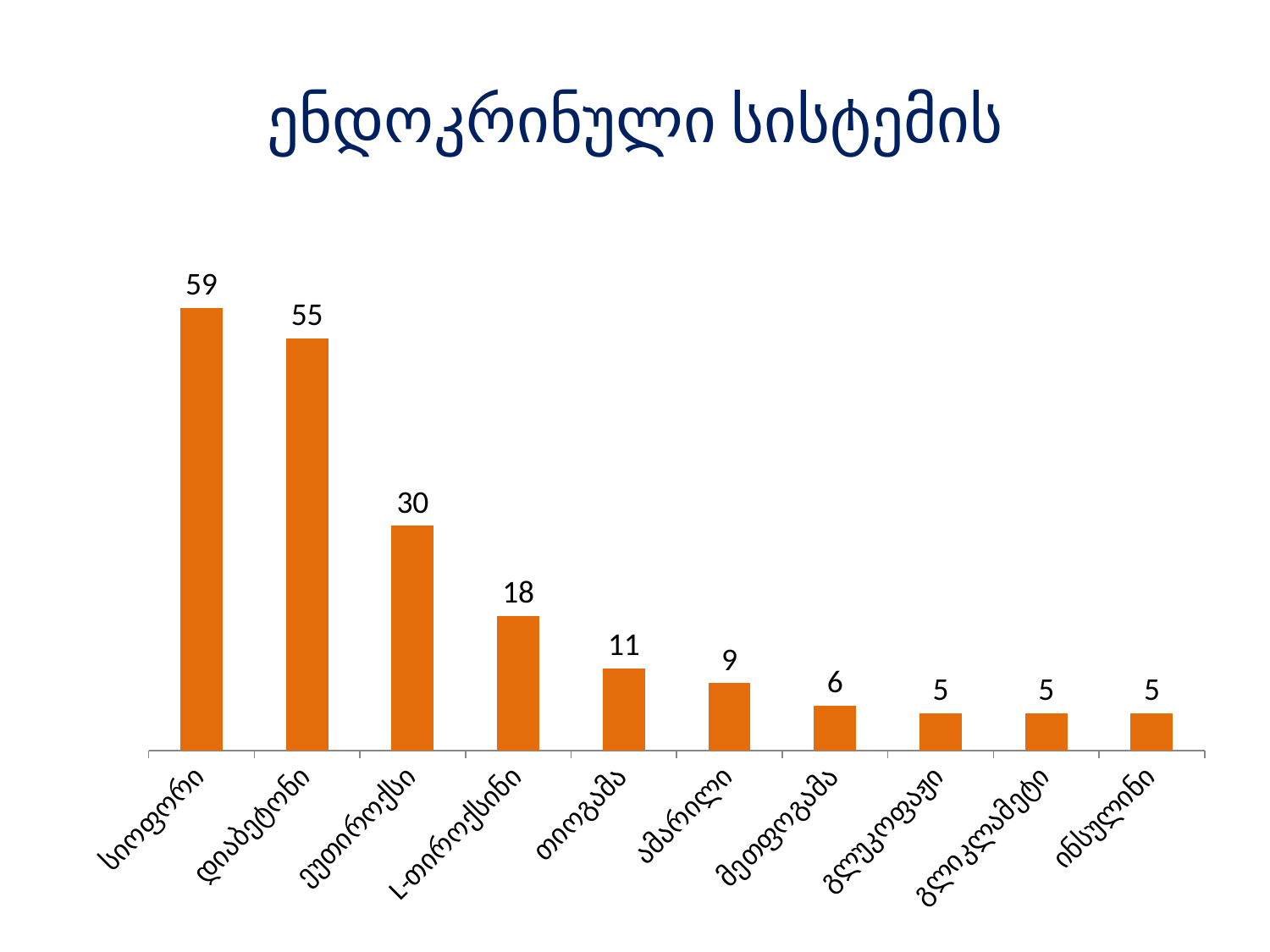
What is the difference between the values for ეუთიროქსი and L-თიროქსინი? 12 Which is larger, the value for ამარილი or the value for მეთფოგამა? ამარილი What is the title of the chart? ენდოკრინული სისტემის What is the difference between the values for სიოფორი and დიაბეტონი? 4 What colour are the bars in the chart? orange How many categories are shown on the x axis? 10 What kind of chart is shown on the slide? bar chart What is the value for თიოგამა? 11 Do the values rise or fall from left to right along the x axis? fall Which category has the highest value? სიოფორი What is the value for სიოფორი? 59 What is the value for ეუთიროქსი? 30